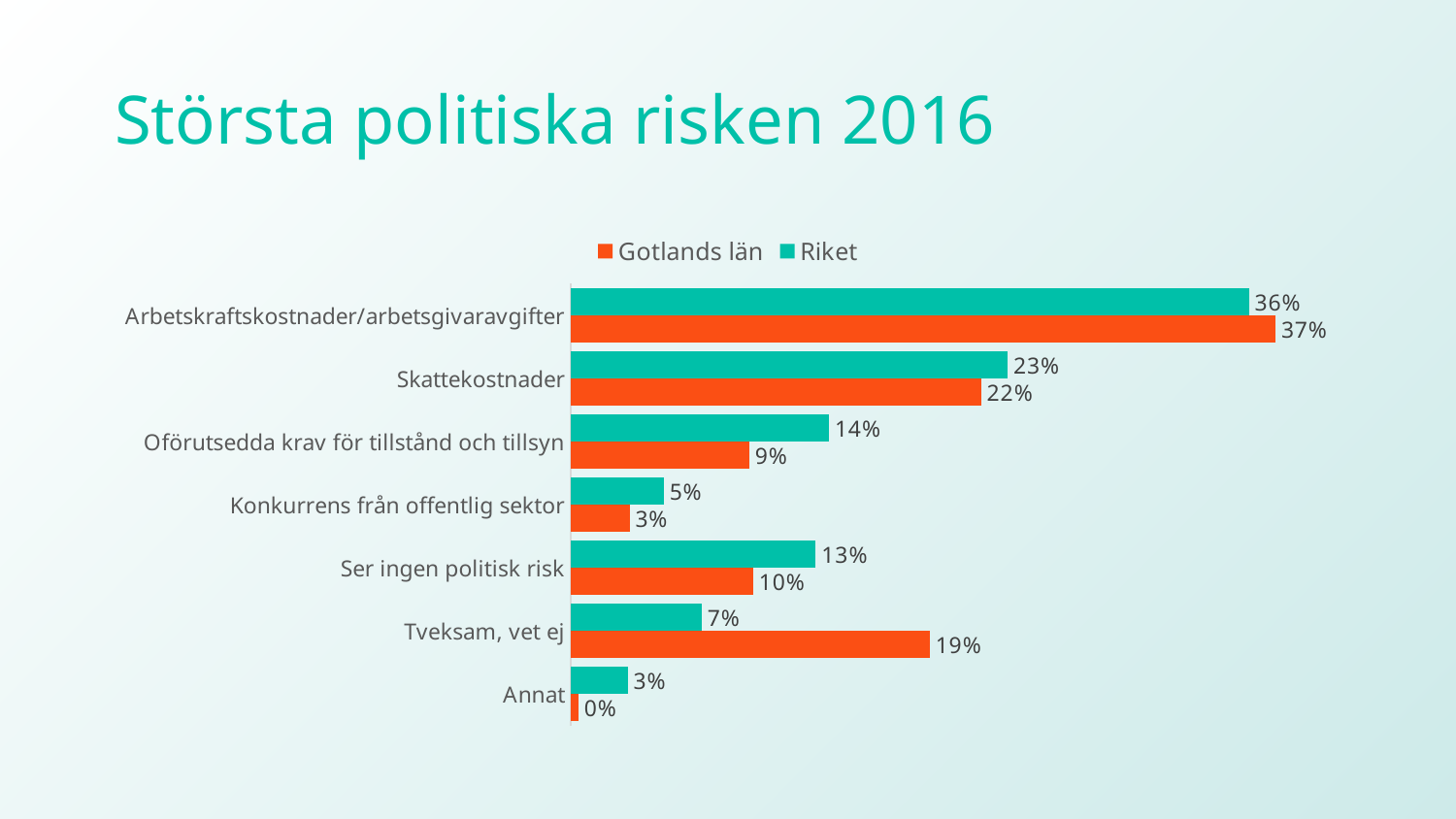
Which category has the lowest value for Gotlands län? Annat How many series does the legend list? 2 What is the title of the slide? Största politiska risken 2016 What is the value for Gotlands län for Arbetskraftskostnader/arbetsgivaravgifter? 37% What is the value for Gotlands län for Tveksam, vet ej? 19% What is the value for Riket for Ser ingen politisk risk? 13% What kind of chart is shown on the slide? Bar chart Which is larger for Oförutsedda krav för tillstånd och tillsyn: Gotlands län or Riket? Riket What is the value for Riket for Skattekostnader? 23% What is the difference between Gotlands län and Riket for Tveksam, vet ej? 12% How many categories are shown on the chart? 7 Which category has the highest value for Riket? Arbetskraftskostnader/arbetsgivaravgifter